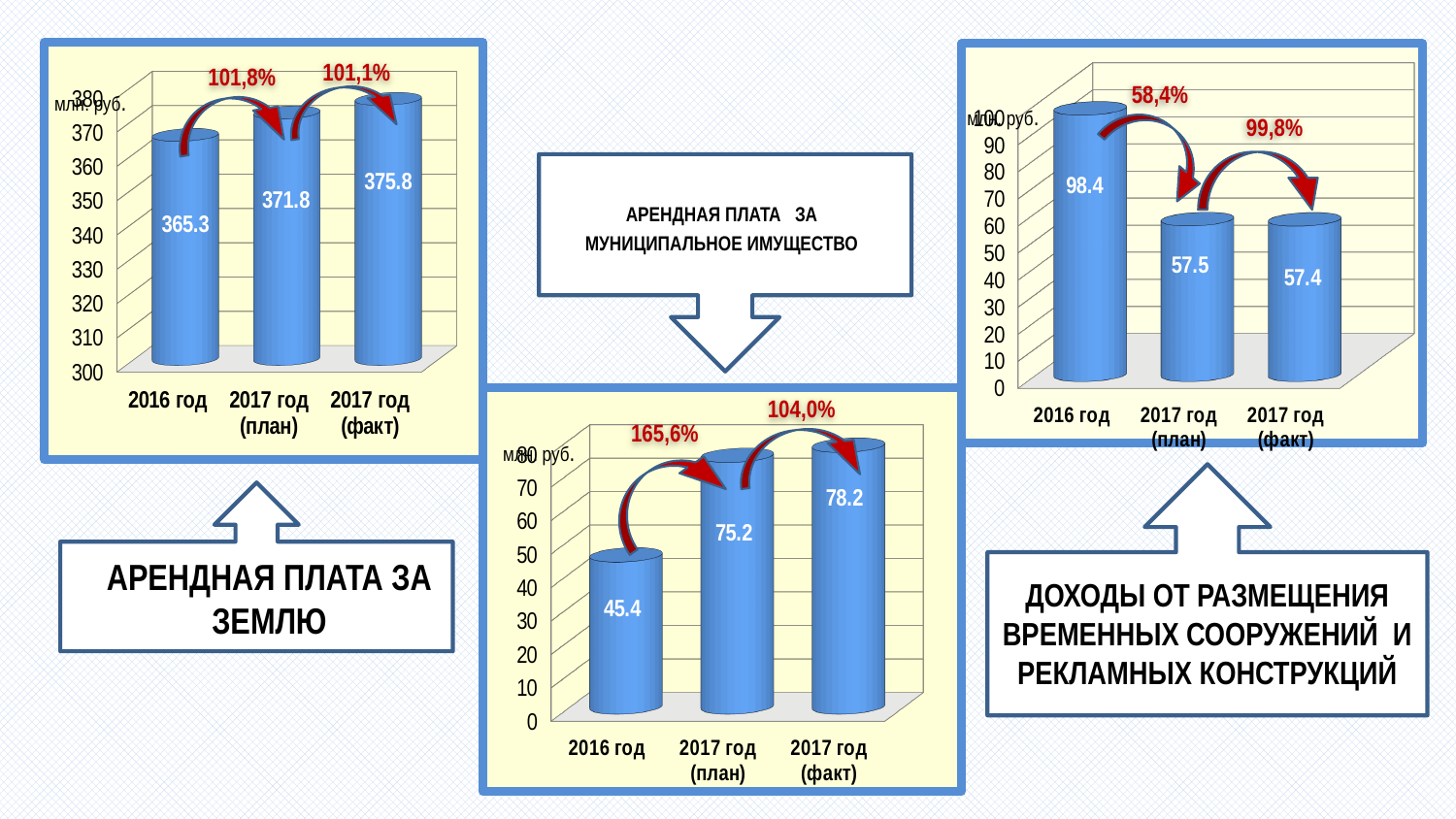
On the left chart (Арендная плата за землю), what is the difference between 2017 год (факт) and 2017 год (план)? 4.0 On the right chart (Доходы от размещения временных сооружений и рекламных конструкций), what is the difference between 2016 год and 2017 год (план)? 40.9 On the middle chart (Арендная плата за муниципальное имущество), which category has the highest value? 2017 год (факт) On the middle chart (Арендная плата за муниципальное имущество), do the values rise or fall from 2016 год to 2017 год (факт)? rise On the middle chart (Арендная плата за муниципальное имущество), what is the value for 2016 год? 45.4 On the left chart (Арендная плата за землю), which category has the lowest value? 2016 год On the right chart (Доходы от размещения временных сооружений и рекламных конструкций), what is the value for 2016 год? 98.4 On the right chart (Доходы от размещения временных сооружений и рекламных конструкций), which category has the highest value? 2016 год On the middle chart (Арендная плата за муниципальное имущество), what is the difference between 2017 год (план) and 2016 год? 29.8 On the left chart (Арендная плата за землю), what is the value for 2016 год? 365.3 On the left chart (Арендная плата за землю), what is the value for 2017 год (факт)? 375.8 How many categories does the right chart (Доходы от размещения временных сооружений и рекламных конструкций) show? 3